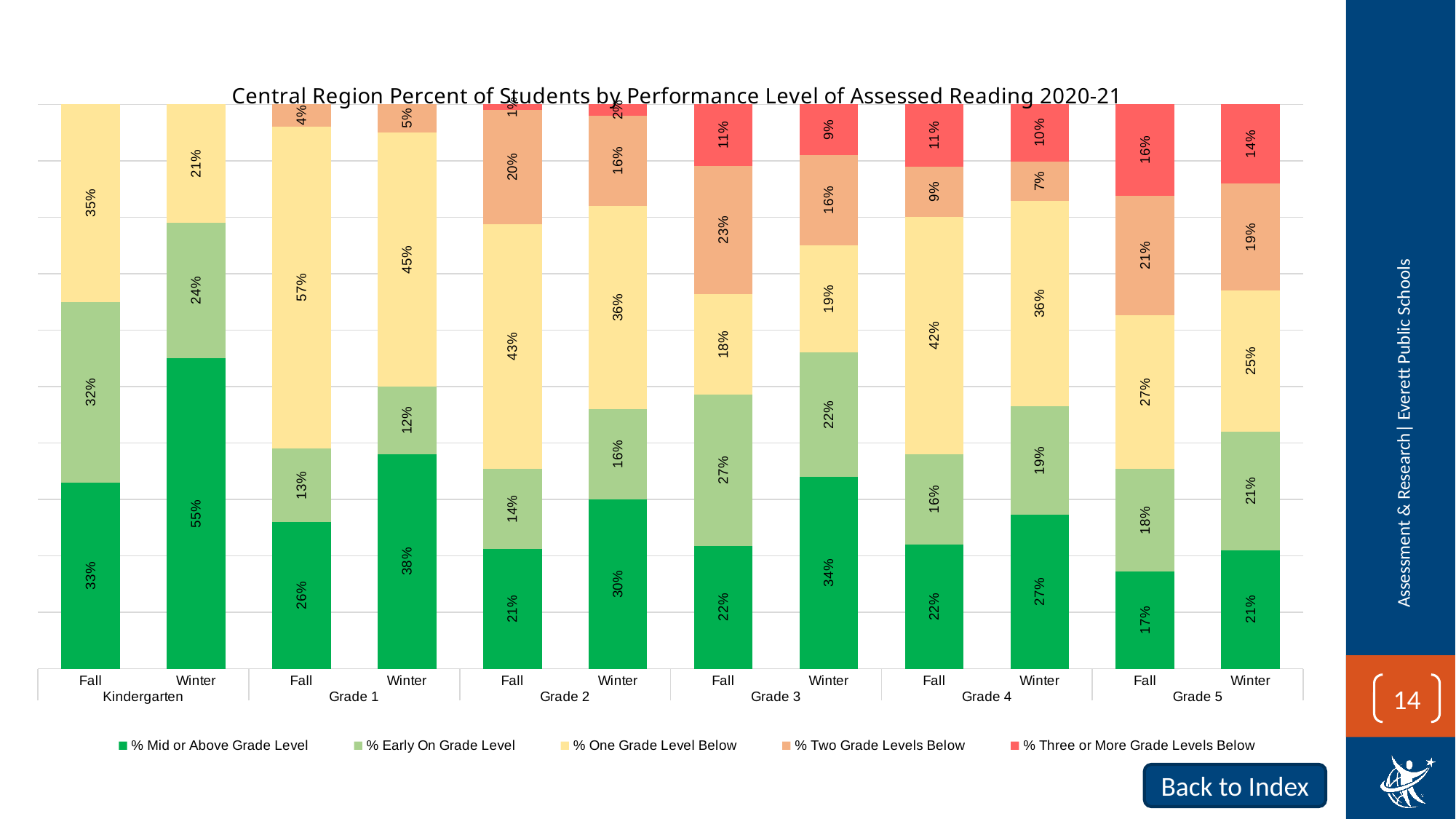
What is the title of the chart? Central Region Percent of Students by Performance Level of Assessed Reading 2020-21 What kind of chart is shown on the slide? Stacked bar chart How many series does the legend list? 5 Which bar has the highest % Mid or Above Grade Level value? Kindergarten Winter What is the difference between the % Mid or Above Grade Level values for Grade 3 Winter and Grade 3 Fall? 12% What is the % Three or More Grade Levels Below value for Grade 5 Fall? 16% Which is larger, the % Early On Grade Level value for Grade 3 Fall or for Grade 4 Fall? Grade 3 Fall How many bars are plotted in the chart? 12 What percentage of Kindergarten Winter students are at Mid or Above Grade Level? 55% What is the % Two Grade Levels Below value for Grade 3 Fall? 23% What is the % One Grade Level Below value for Grade 1 Fall? 57% Which bar has the lowest % Mid or Above Grade Level value? Grade 5 Fall